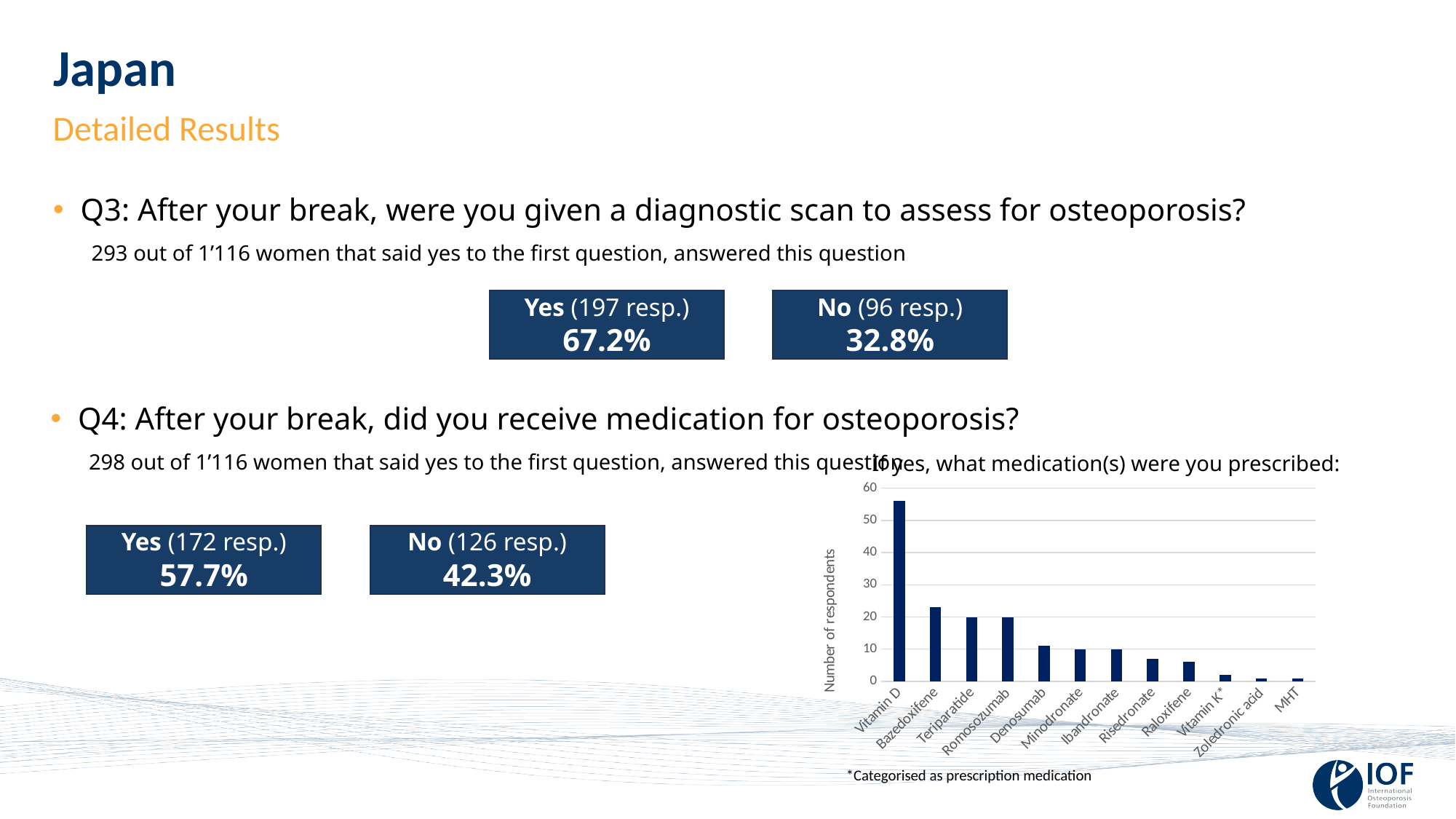
Do the bar values generally rise or fall from left to right along the x axis? fall What is the title of the chart? If yes, what medication(s) were you prescribed: Which medication has the highest number of respondents in the chart? Vitamin D Is the value for Vitamin K* greater or less than 10? less Is the value for Vitamin D greater or less than 50? greater What kind of chart is shown on the slide? bar chart Is the value for Risedronate greater or less than 10? less Which has more respondents, Bazedoxifene or Denosumab? Bazedoxifene How many medication categories are shown on the x axis of the chart? 12 What is the label of the vertical axis of the chart? Number of respondents